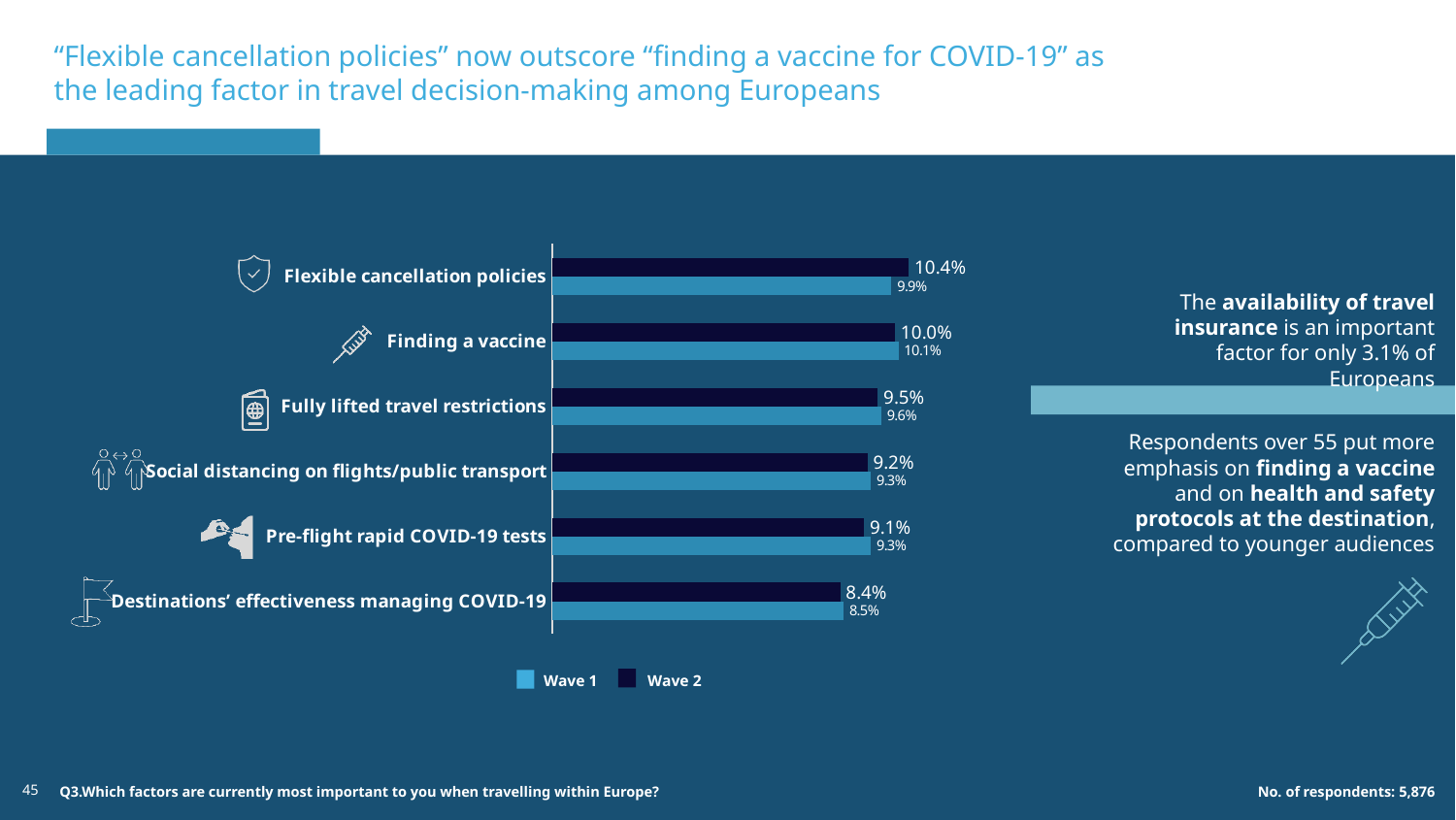
What is the Wave 2 value for Flexible cancellation policies? 10.4% What is the difference between the Wave 2 and Wave 1 values for Flexible cancellation policies? 0.5% Which category has the lowest Wave 1 value? Destinations' effectiveness managing COVID-19 What is the Wave 2 value for Fully lifted travel restrictions? 9.5% Which colour represents Wave 2 in the chart? Dark navy How many series does the legend list? 2 What is the Wave 1 value for Destinations' effectiveness managing COVID-19? 8.5% For Finding a vaccine, which is larger: the Wave 1 value or the Wave 2 value? Wave 1 What is the Wave 1 value for Finding a vaccine? 10.1% How many categories are shown in the chart? 6 What kind of chart is shown on the slide? Bar chart Which category has the highest Wave 2 value? Flexible cancellation policies